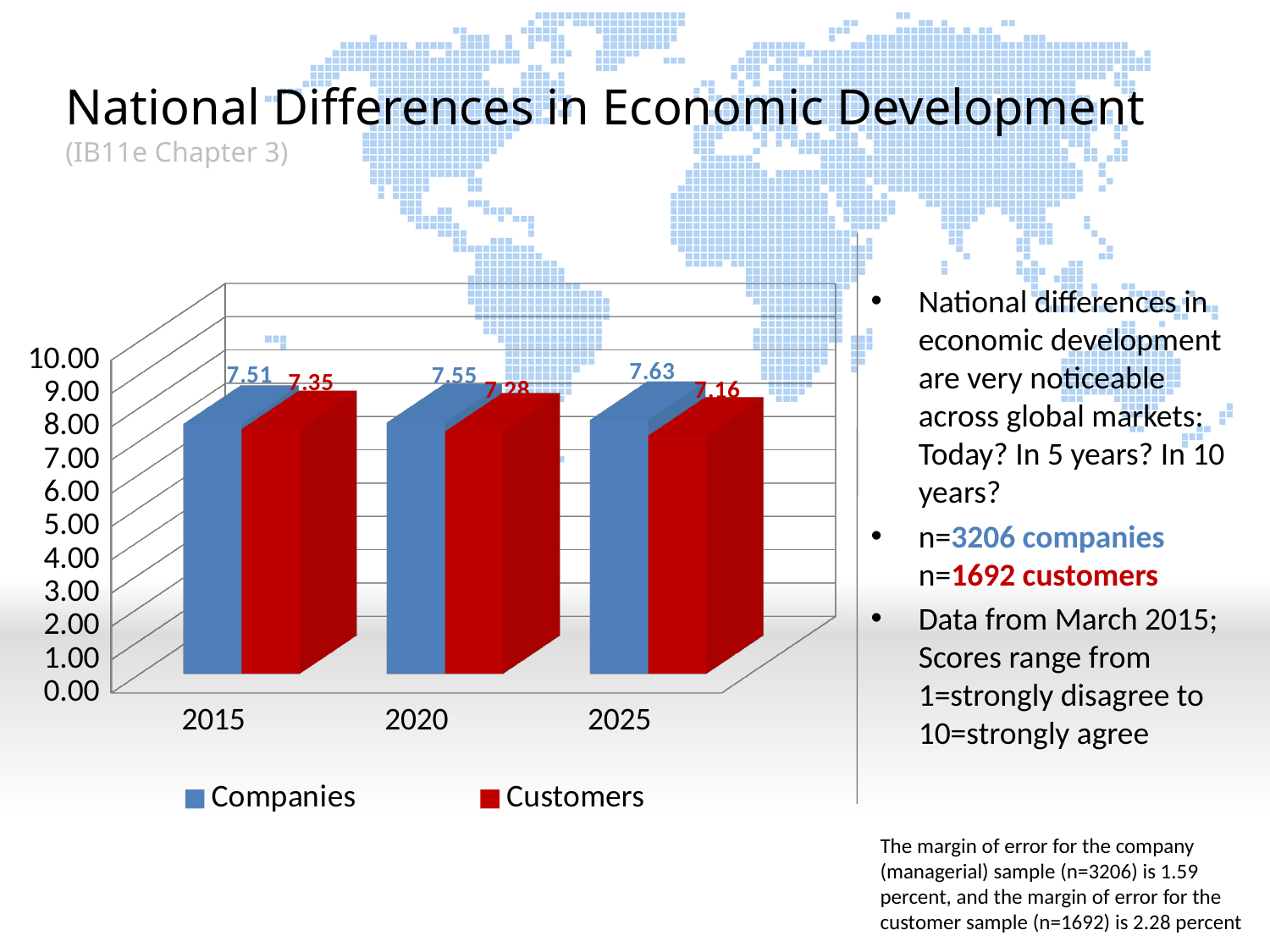
What is the value for Customers in 2015? 7.35 In which year is the Companies value highest? 2025 Do the Customers values rise or fall from 2015 to 2025? fall What is the value for Companies in 2025? 7.63 What is the difference between the Companies and Customers values in 2025? 0.47 Which is larger in 2025, the Companies value or the Customers value? Companies What is the value for Customers in 2025? 7.16 What is the difference between the Companies and Customers values in 2015? 0.16 In which year is the Customers value lowest? 2025 What is the value for Companies in 2015? 7.51 How many years are shown on the x axis? 3 How many series does the legend list? 2